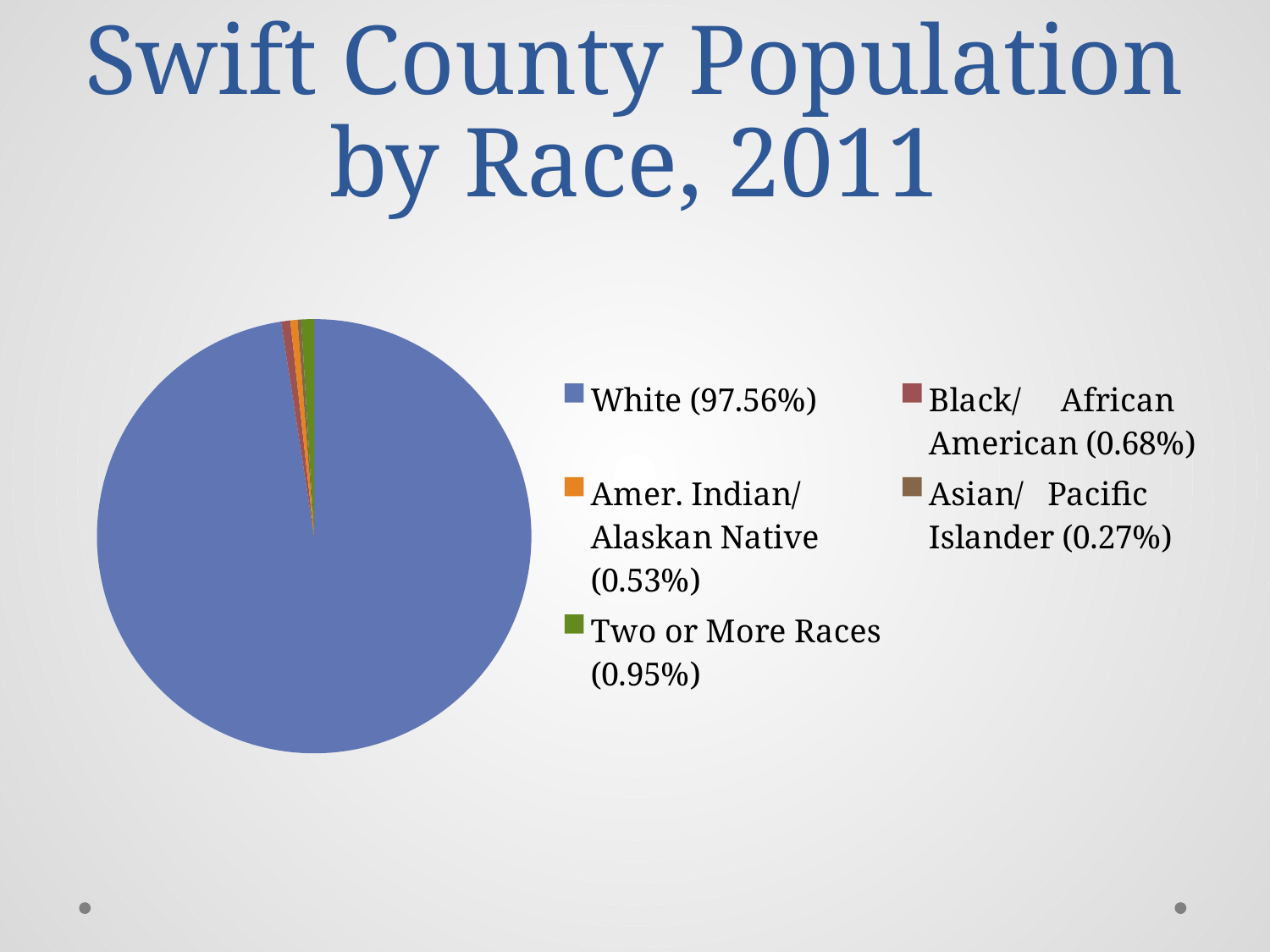
How many categories does the pie chart show? 5 Which race category has the smallest share of the pie? Asian/Pacific Islander Which race category has the largest share of the pie? White What kind of chart is shown on the slide? pie chart What percentage is shown for Black/African American? 0.68% What percentage is shown for Amer. Indian/Alaskan Native? 0.53% What is the difference between the Black/African American share and the Asian/Pacific Islander share? 0.41% Which is larger, the share for Two or More Races or the share for Black/African American? Two or More Races What percentage is shown for Asian/Pacific Islander? 0.27% What percentage is shown for Two or More Races? 0.95% What colour is the slice representing White? blue What share of the Swift County population is White according to the legend? 97.56%